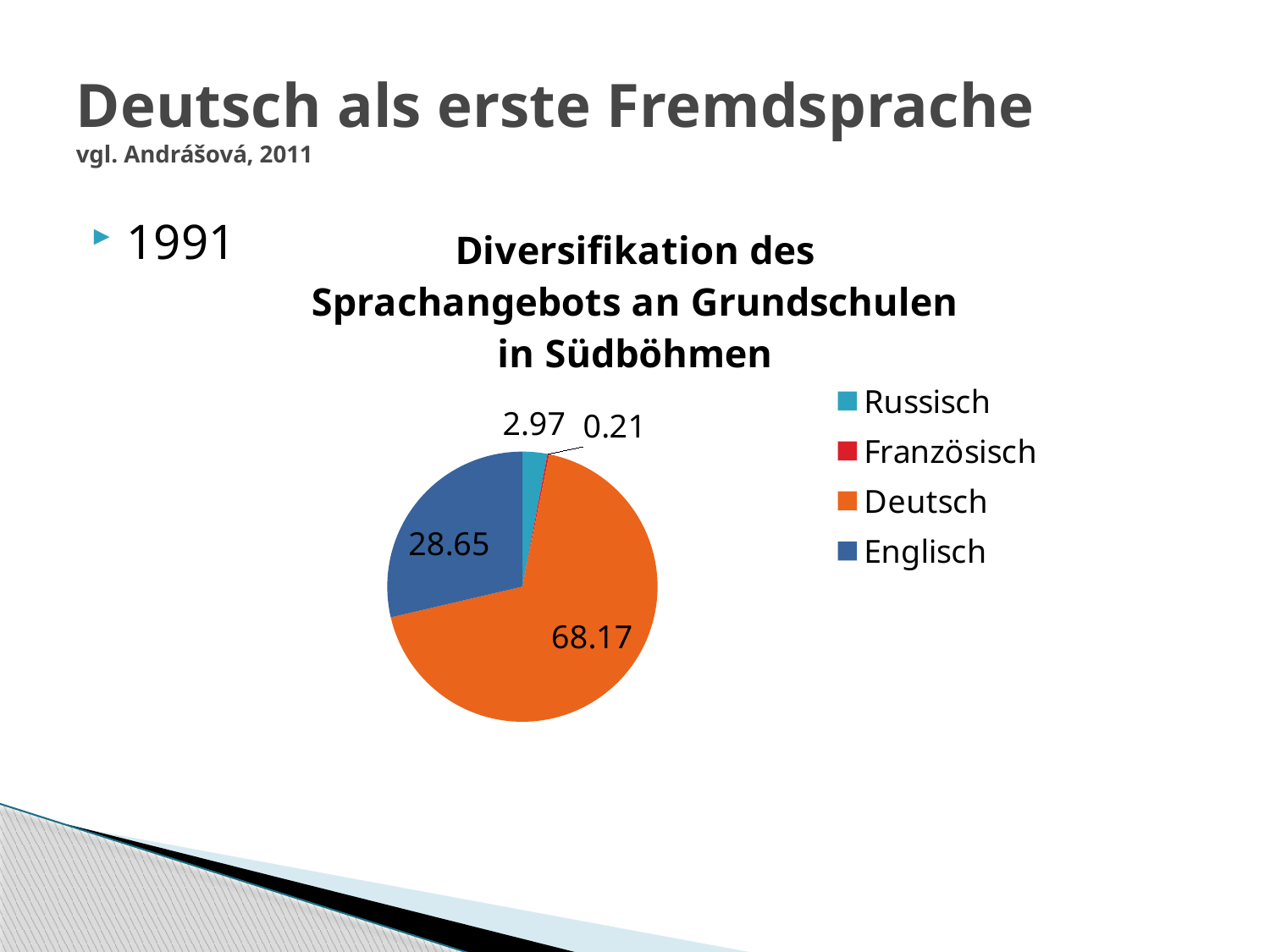
Which language has the smallest slice of the pie chart? Französisch Which is larger, the value for Englisch or the value for Russisch? Englisch What value is shown for Deutsch in the pie chart? 68.17 What is the title of the chart? Diversifikation des Sprachangebots an Grundschulen in Südböhmen What value is shown for Englisch in the pie chart? 28.65 What is the difference between the values for Russisch and Französisch? 2.76 What kind of chart is shown on the slide? Pie chart How many languages are shown in the pie chart? 4 Which language has the largest slice of the pie chart? Deutsch What is the difference between the values for Deutsch and Englisch? 39.52 What value is shown for Französisch in the pie chart? 0.21 What value is shown for Russisch in the pie chart? 2.97